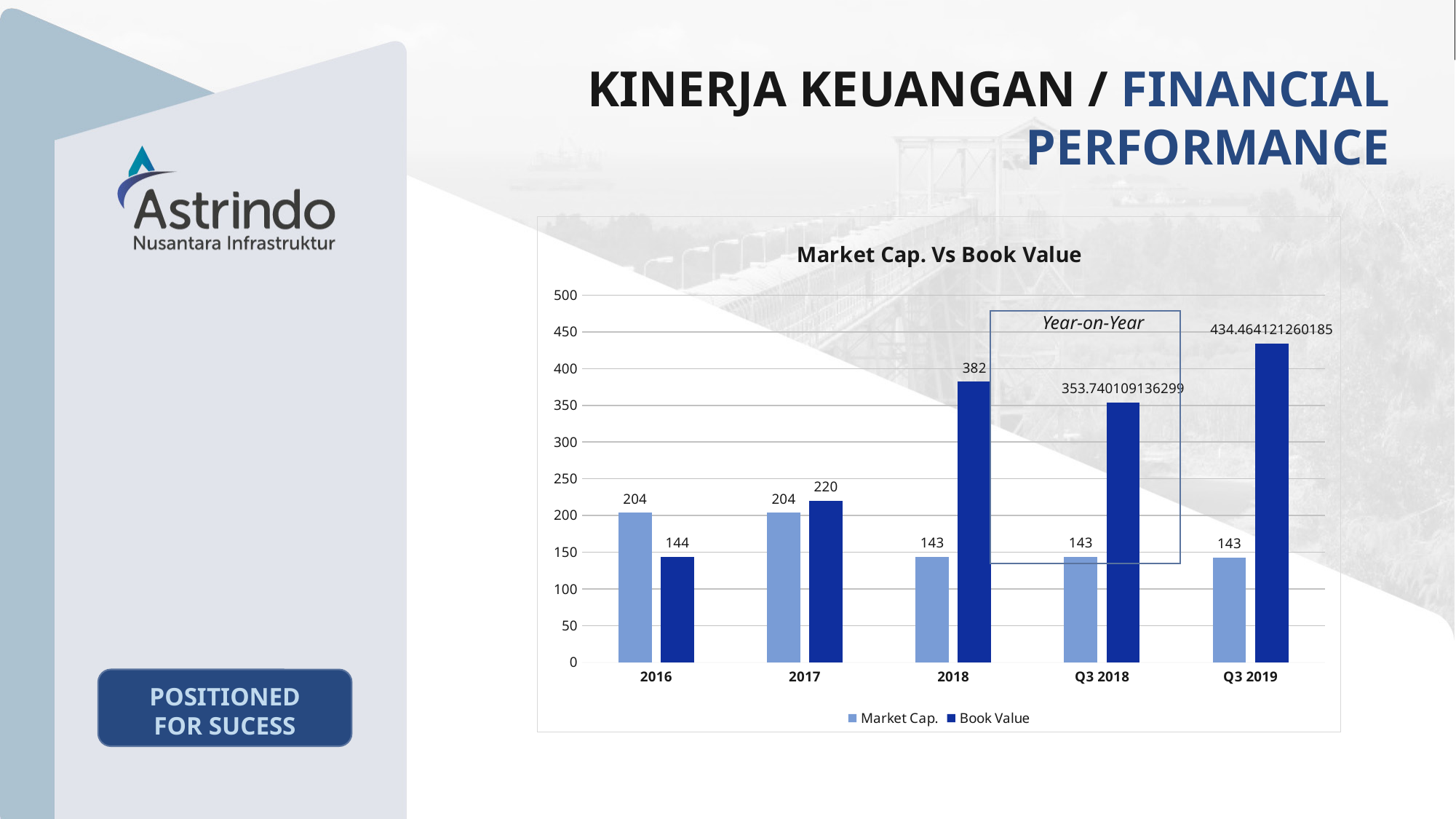
What is the Book Value for Q3 2019? 434.464121260185 Which category has the lowest Book Value? 2016 What is the title of the chart? Market Cap. Vs Book Value What is the Book Value for 2017? 220 What is the Market Cap. value for 2016? 204 What is the Book Value for 2018? 382 How many series does the legend list? 2 What kind of chart is shown on the slide? Bar chart Which category has the highest Book Value? Q3 2019 Which is larger in 2016, Market Cap. or Book Value? Market Cap. What is the difference between Book Value and Market Cap. in 2018? 239 How many categories are shown on the x axis? 5